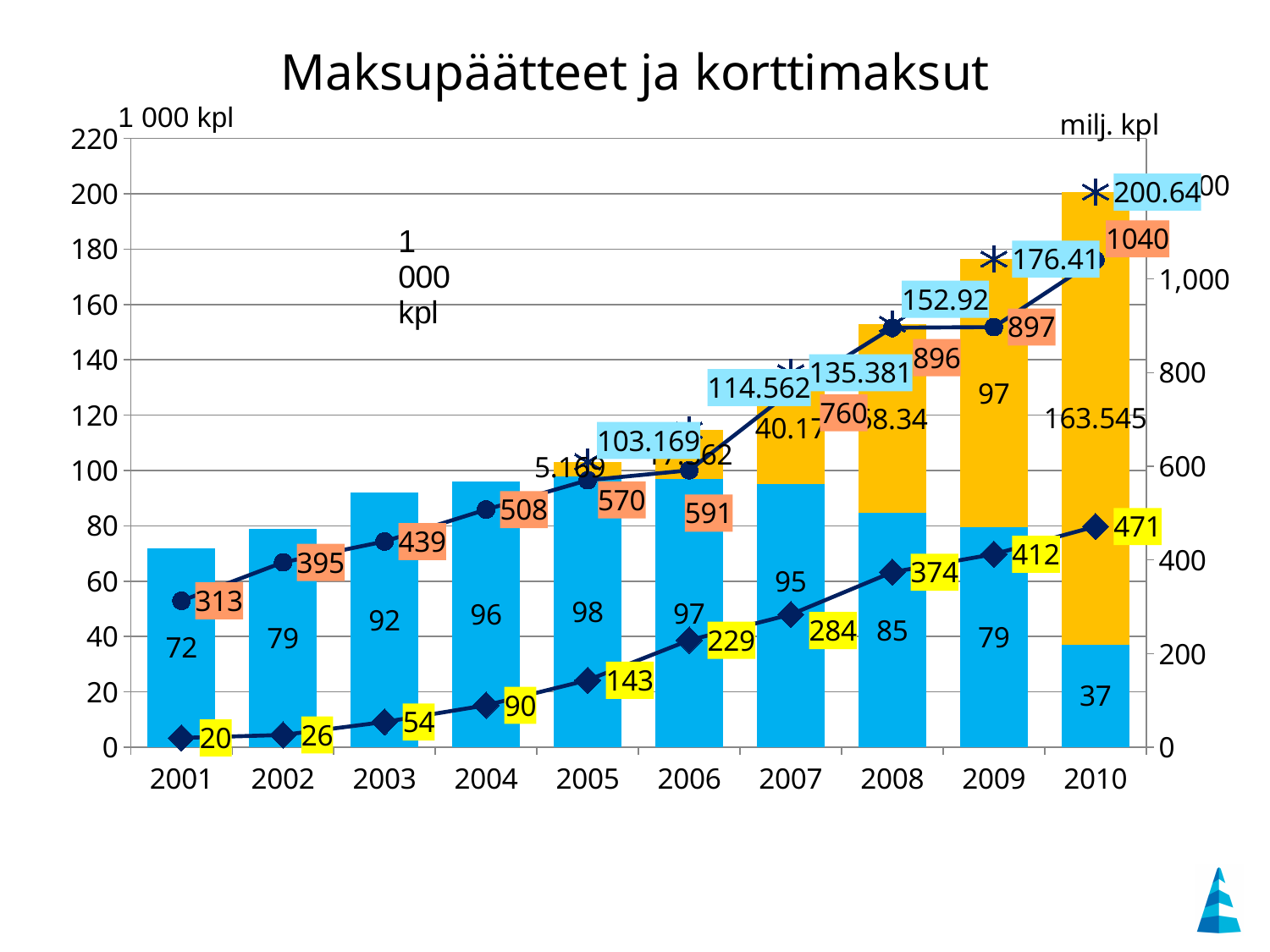
What is the value of the blue bar for 2003? 92 What is the value of the blue bar for 2010? 37 How many years are shown on the x axis? 10 Do the values on the diamond-marker line rise or fall from 2001 to 2010? rise What is the difference between the diamond-marker line values for 2010 and 2009? 59 What is the value labelled on the diamond-marker line for 2006? 229 Which is larger, the blue bar for 2002 or the blue bar for 2008? 2008 What is the value labelled on the circle-marker line (orange labels) for 2001? 313 What is the title of the chart? Maksupäätteet ja korttimaksut What is the value labelled on the circle-marker line (orange labels) for 2010? 1040 Which year has the tallest blue bar? 2005 Which year has the shortest blue bar? 2010